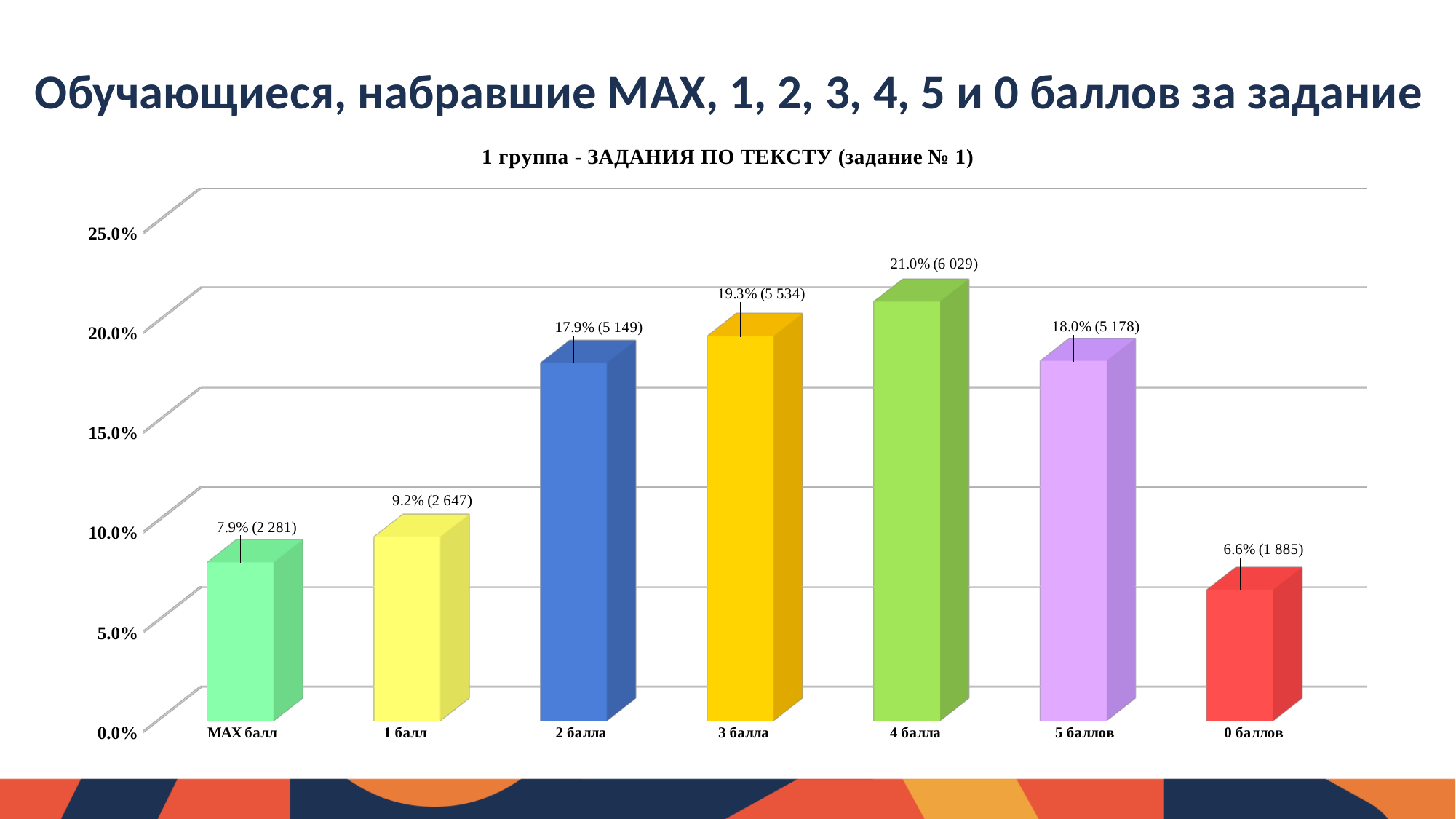
What percentage is shown for the "0 баллов" category? 6.6% What is the difference in percentage points between "4 балла" and "MAX балл"? 13.1 What percentage is shown for the "4 балла" category? 21.0% Which category has the lowest percentage? 0 баллов Which is larger, the percentage for "2 балла" or for "5 баллов"? 5 баллов What is the count shown in parentheses for the "MAX балл" category? 2 281 Is the value for "1 балл" greater or less than 10.0%? less How many categories are shown on the x axis? 7 What is the count shown in parentheses for the "3 балла" category? 5 534 What is the title of the chart? 1 группа - ЗАДАНИЯ ПО ТЕКСТУ (задание № 1) What kind of chart is shown on the slide? bar chart Which category has the highest percentage? 4 балла